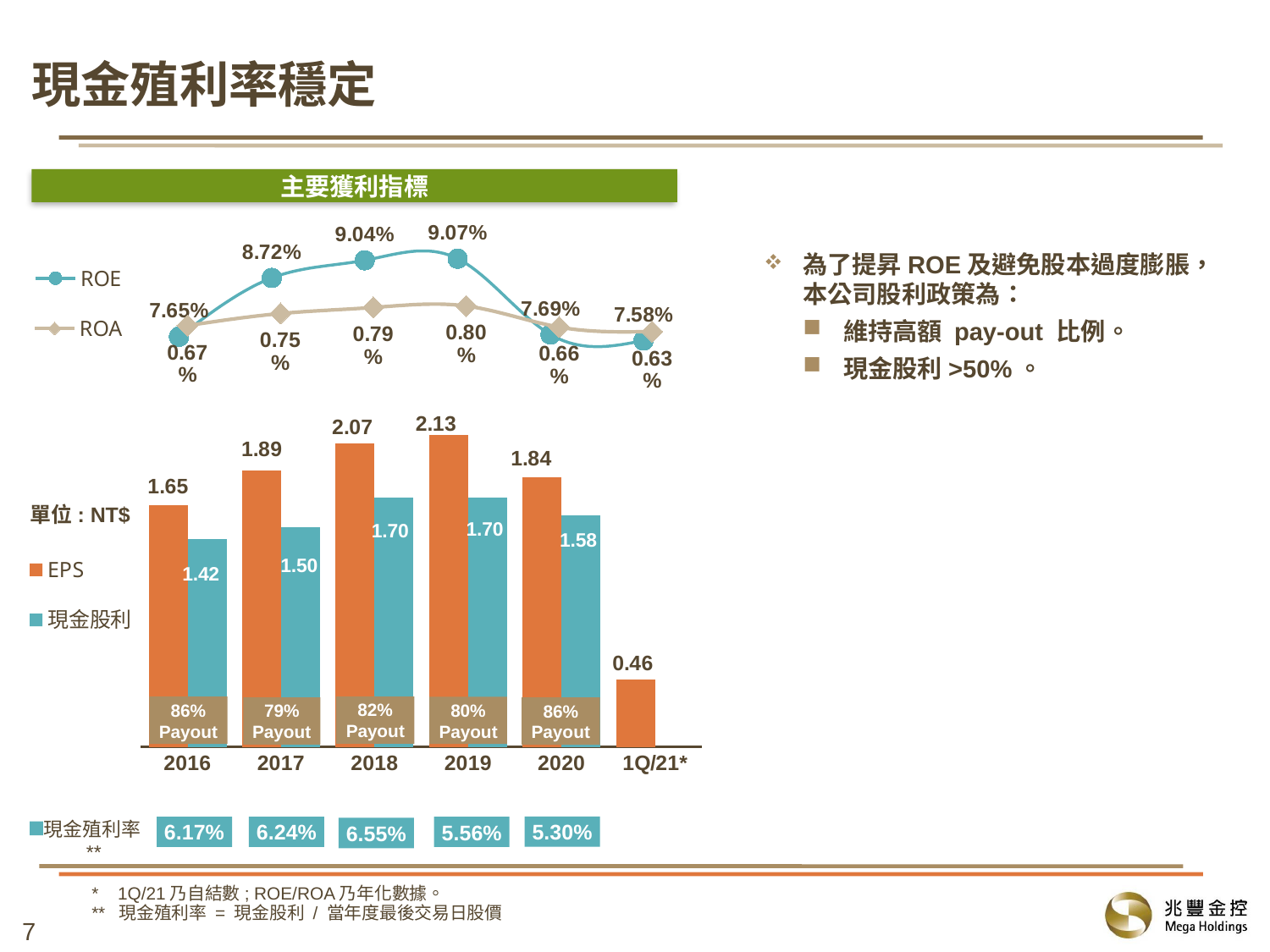
In the top line chart, what is the ROA value for 2017? 0.75% In the bottom bar chart, what is the EPS for 2018? 2.07 In the bottom bar chart, what is the difference between EPS and 現金股利 in 2019? 0.43 In the top line chart, does ROE rise or fall from 2016 to 2019? rise In the bottom bar chart, what is the 現金股利 (cash dividend) for 2020? 1.58 In the top line chart, which year has the highest ROE? 2019 How many series does the legend of the top line chart list? 2 In the top line chart, what is the lowest ROA value shown? 0.63% In the top line chart, what is the ROE value for 2019? 9.07% In the bottom bar chart, which year has the highest EPS? 2019 In the bottom bar chart, which is larger: EPS in 2016 or EPS in 2017? 2017 How many year categories are shown on the x axis of the bottom bar chart? 6